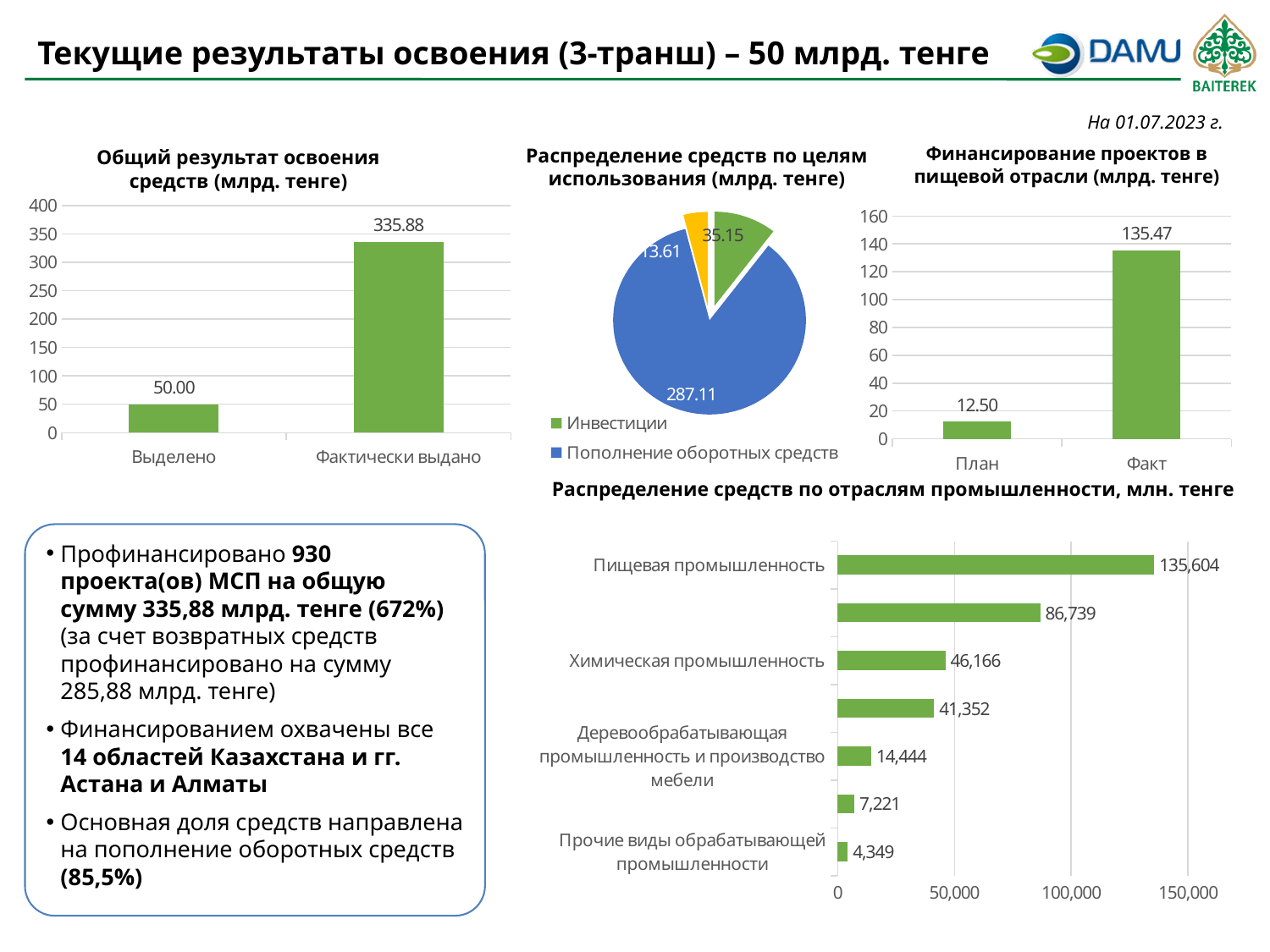
In the chart 'Общий результат освоения средств (млрд. тенге)', what is the value for 'Фактически выдано'? 335.88 In the chart 'Финансирование проектов в пищевой отрасли (млрд. тенге)', what is the difference between 'Факт' and 'План'? 122.97 How many bars are plotted in the chart 'Распределение средств по отраслям промышленности, млн. тенге'? 7 In the pie chart 'Распределение средств по целям использования (млрд. тенге)', what is the value for 'Пополнение оборотных средств'? 287.11 In the chart 'Финансирование проектов в пищевой отрасли (млрд. тенге)', which is larger, 'План' or 'Факт'? Факт What kind of chart is 'Распределение средств по отраслям промышленности, млн. тенге'? Bar chart In the chart 'Распределение средств по отраслям промышленности, млн. тенге', what is the value for 'Химическая промышленность'? 46,166 In the chart 'Финансирование проектов в пищевой отрасли (млрд. тенге)', what is the value for 'Факт'? 135.47 In the pie chart 'Распределение средств по целям использования (млрд. тенге)', what is the value for 'Инвестиции'? 35.15 How many entries does the legend of the pie chart 'Распределение средств по целям использования (млрд. тенге)' list? 2 In the chart 'Распределение средств по отраслям промышленности, млн. тенге', which category has the highest value? Пищевая промышленность In the chart 'Общий результат освоения средств (млрд. тенге)', what is the difference between 'Фактически выдано' and 'Выделено'? 285.88